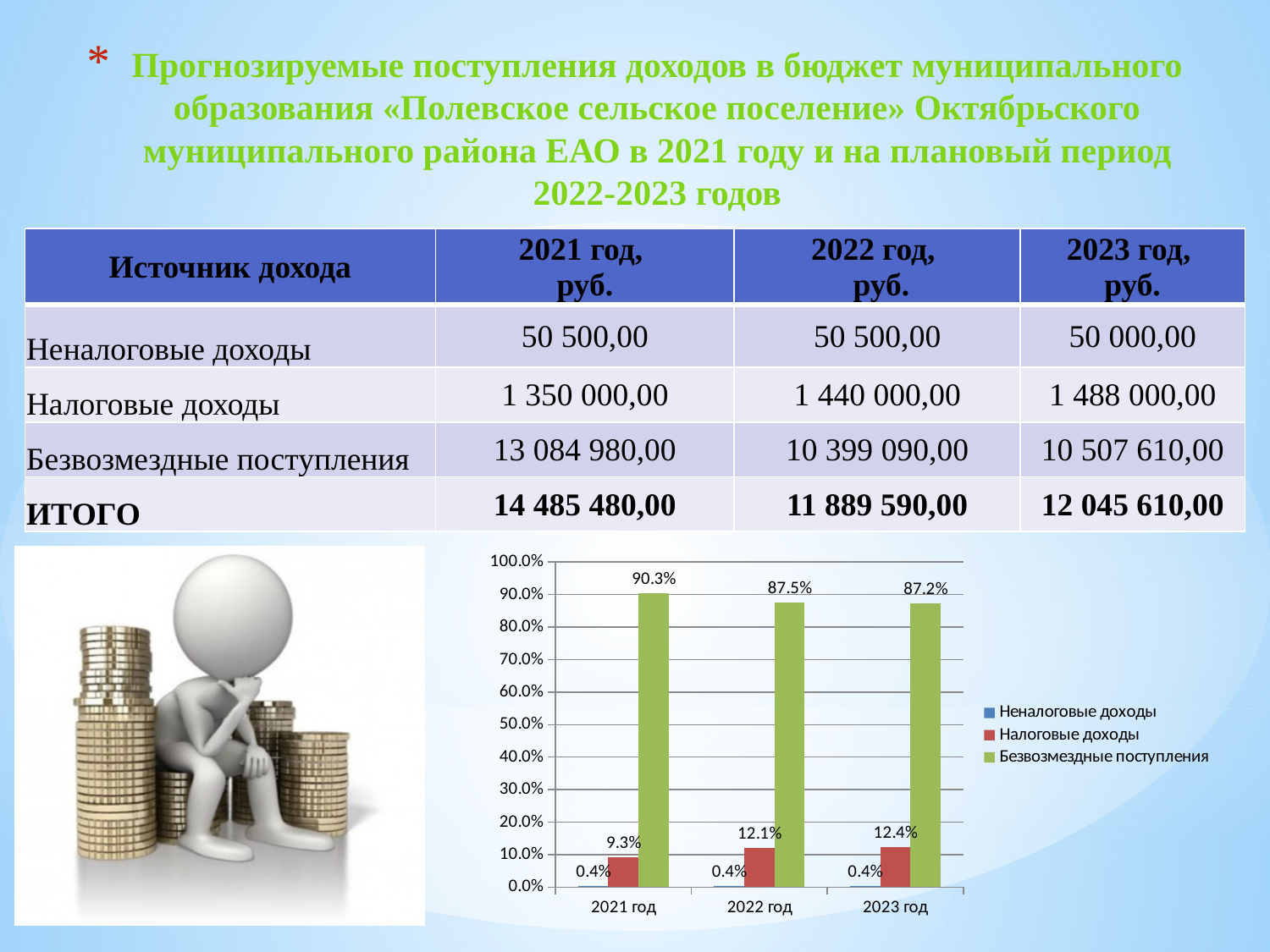
What is the value for Безвозмездные поступления in 2023 год? 87.2% What kind of chart is shown on the slide? bar chart In which year is the value for Безвозмездные поступления highest? 2021 год How many year categories are shown on the x axis of the chart? 3 How many series does the chart legend list? 3 In which year is the value for Налоговые доходы lowest? 2021 год Which is larger: Налоговые доходы in 2023 год or Налоговые доходы in 2021 год? Налоговые доходы in 2023 год What is the value for Налоговые доходы in 2022 год? 12.1% What is the difference between the Безвозмездные поступления values for 2021 год and 2022 год? 2.8% What is the value for Неналоговые доходы in 2023 год? 0.4% Does the share of Налоговые доходы rise or fall from 2021 год to 2023 год? rise What is the value for Безвозмездные поступления in 2021 год? 90.3%